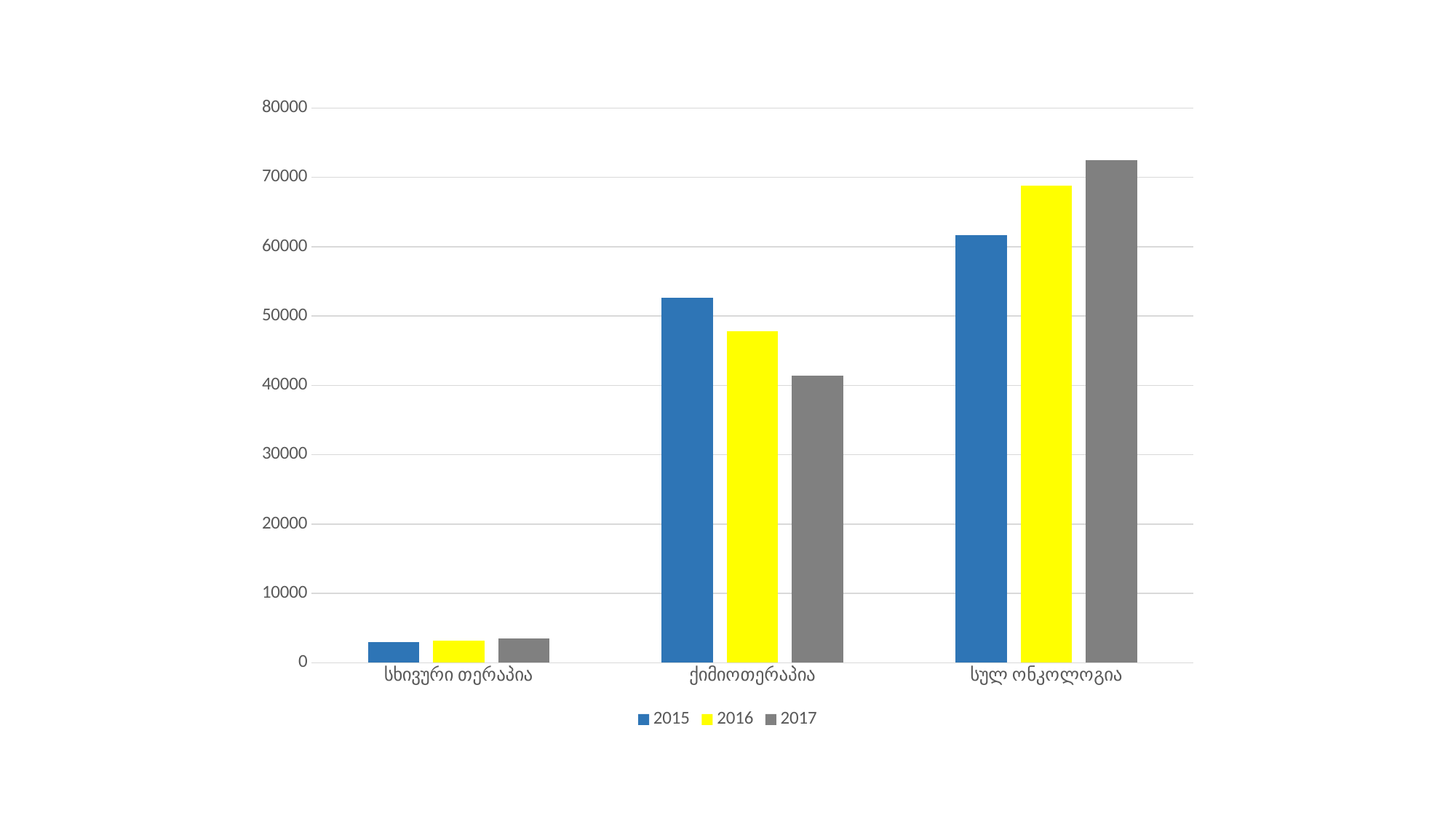
Is the value for სულ ონკოლოგია in 2017 greater or less than 70000? greater For ქიმიოთერაპია, do the values rise or fall from 2015 to 2017? fall Is the value for ქიმიოთერაპია in 2015 greater or less than 50000? greater Is the value for სხივური თერაპია in 2017 greater or less than 10000? less Which category has the highest value for 2017? სულ ონკოლოგია How many series does the legend list? 3 Which colour represents the 2016 series in the legend? yellow What kind of chart is shown on the slide? bar chart How many categories are shown on the x axis? 3 For ქიმიოთერაპია, which year has the larger value, 2015 or 2017? 2015 Which category has the lowest value for 2016? სხივური თერაპია